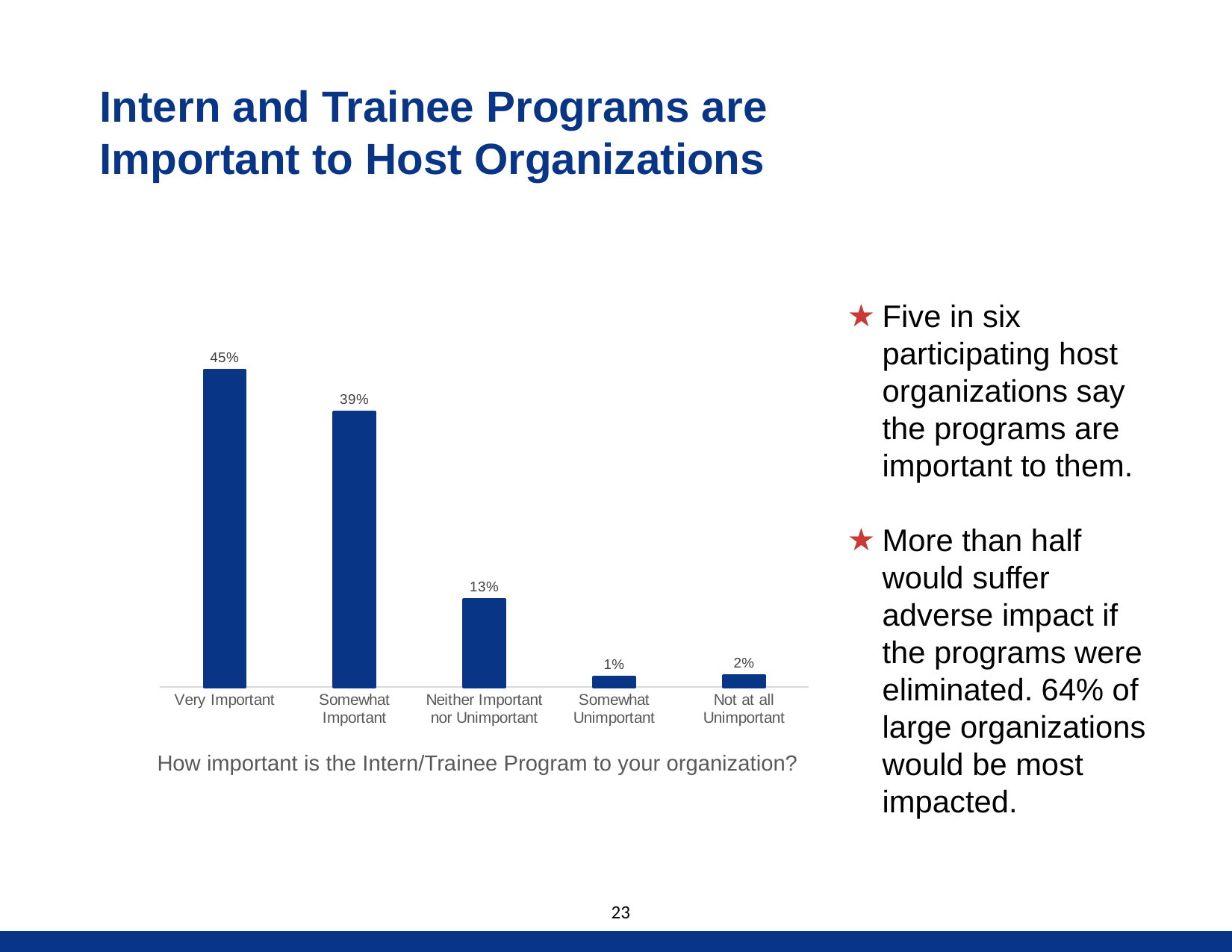
Which is larger, the value for Somewhat Unimportant or the value for Not at all Unimportant? Not at all Unimportant Which category has the lowest value? Somewhat Unimportant What percentage of respondents said the Intern/Trainee Program is Very Important to their organization? 45% What is the difference between the Somewhat Important and Neither Important nor Unimportant values? 26% How many categories are shown on the chart? 5 What is the value for Not at all Unimportant? 2% What percentage is shown for Neither Important nor Unimportant? 13% What is the difference between the Very Important and Somewhat Important values? 6% What survey question is shown beneath the chart? How important is the Intern/Trainee Program to your organization? What is the value shown for Somewhat Important? 39% What kind of chart is shown on the slide? Bar chart Which category has the highest value? Very Important